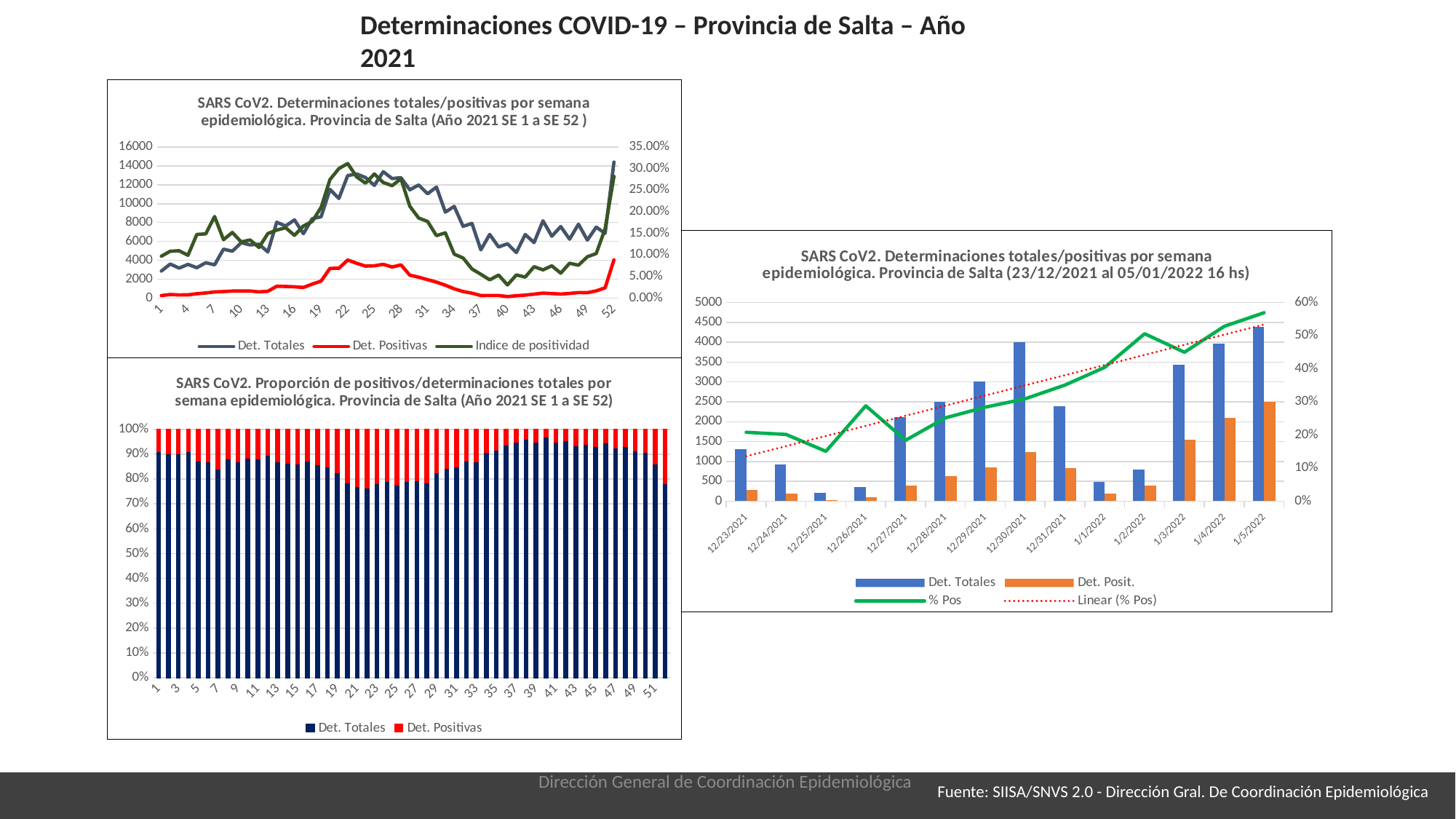
What kind of chart is the bottom-left chart (Proporción de positivos/determinaciones totales)? bar chart On the bottom-left chart (Proporción de positivos/determinaciones totales), how many series does the legend list? 2 On the right-hand chart (23/12/2021 al 05/01/2022), is the Det. Totales value for 12/30/2021 greater or less than 3500? greater On the right-hand chart (23/12/2021 al 05/01/2022), do the Det. Totales bars rise or fall from 1/1/2022 to 1/5/2022? rise On the top-left chart (Año 2021 SE 1 a SE 52), how many series does the legend list? 3 On the right-hand chart (23/12/2021 al 05/01/2022), which date has the lowest Det. Totales bar? 12/25/2021 On the right-hand chart (23/12/2021 al 05/01/2022), is the Det. Posit. value for 1/5/2022 greater or less than 2000? greater On the right-hand chart (23/12/2021 al 05/01/2022), which date has the larger Det. Totales value, 12/29/2021 or 12/31/2021? 12/29/2021 On the right-hand chart (23/12/2021 al 05/01/2022), how many entries does the legend list? 4 On the right-hand chart (23/12/2021 al 05/01/2022), how many dates are shown on the x axis? 14 On the right-hand chart (23/12/2021 al 05/01/2022), which date has the highest Det. Totales bar? 1/5/2022 What kind of chart is the top-left chart (Determinaciones totales/positivas por semana epidemiológica, SE 1 a SE 52)? line chart